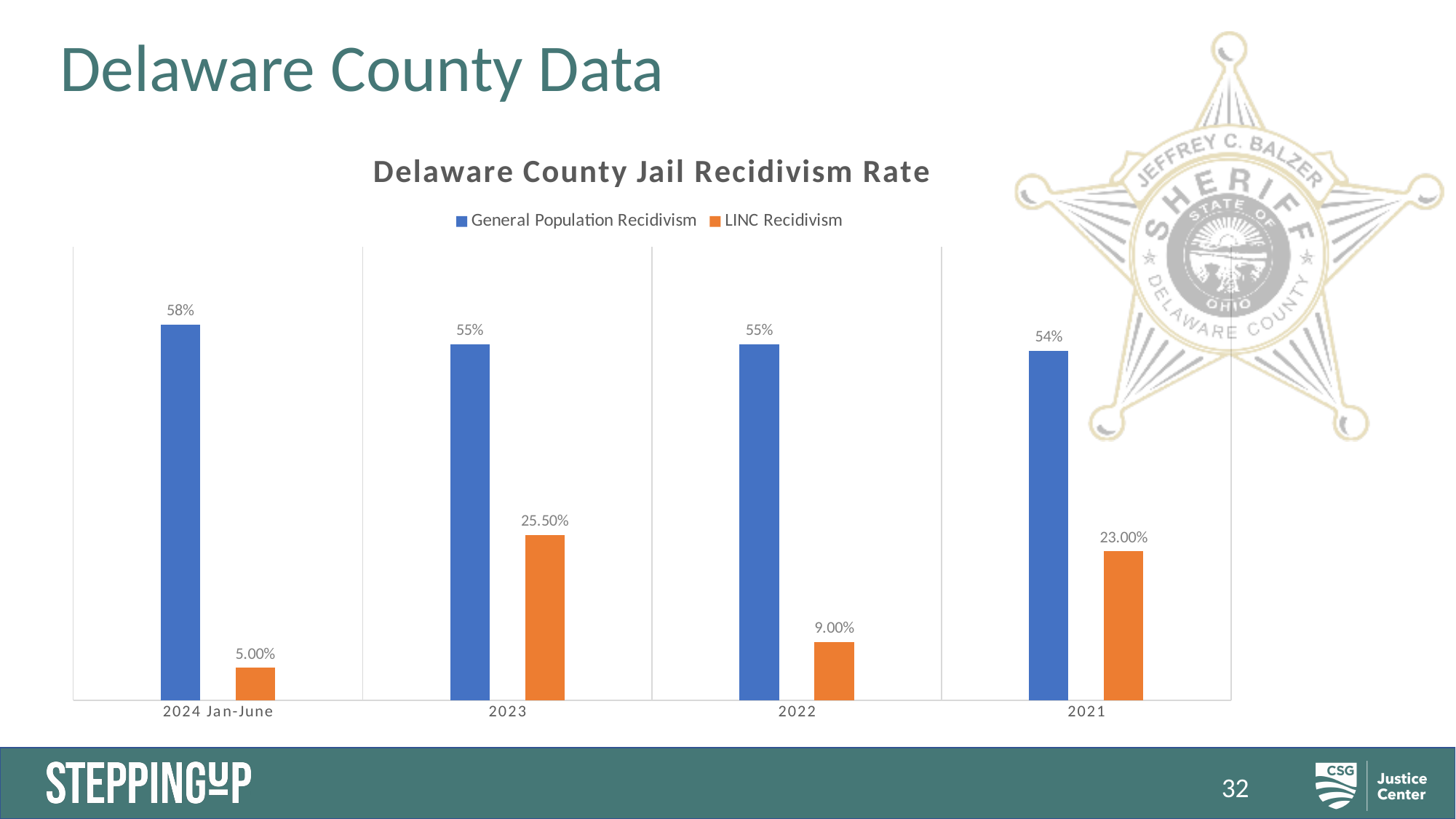
How many categories are shown on the x axis? 4 Which is larger for 2022: General Population Recidivism or LINC Recidivism? General Population Recidivism What is the LINC Recidivism rate for 2022? 9.00% What is the General Population Recidivism rate for 2021? 54% What is the difference between the LINC Recidivism rates for 2023 and 2021? 2.50% What is the LINC Recidivism rate for 2023? 25.50% Which category has the highest General Population Recidivism rate? 2024 Jan-June Which category has the lowest LINC Recidivism rate? 2024 Jan-June Which category has the highest LINC Recidivism rate? 2023 How many series does the legend list? 2 What kind of chart is shown on the slide? Bar chart What is the General Population Recidivism rate for 2024 Jan-June? 58%